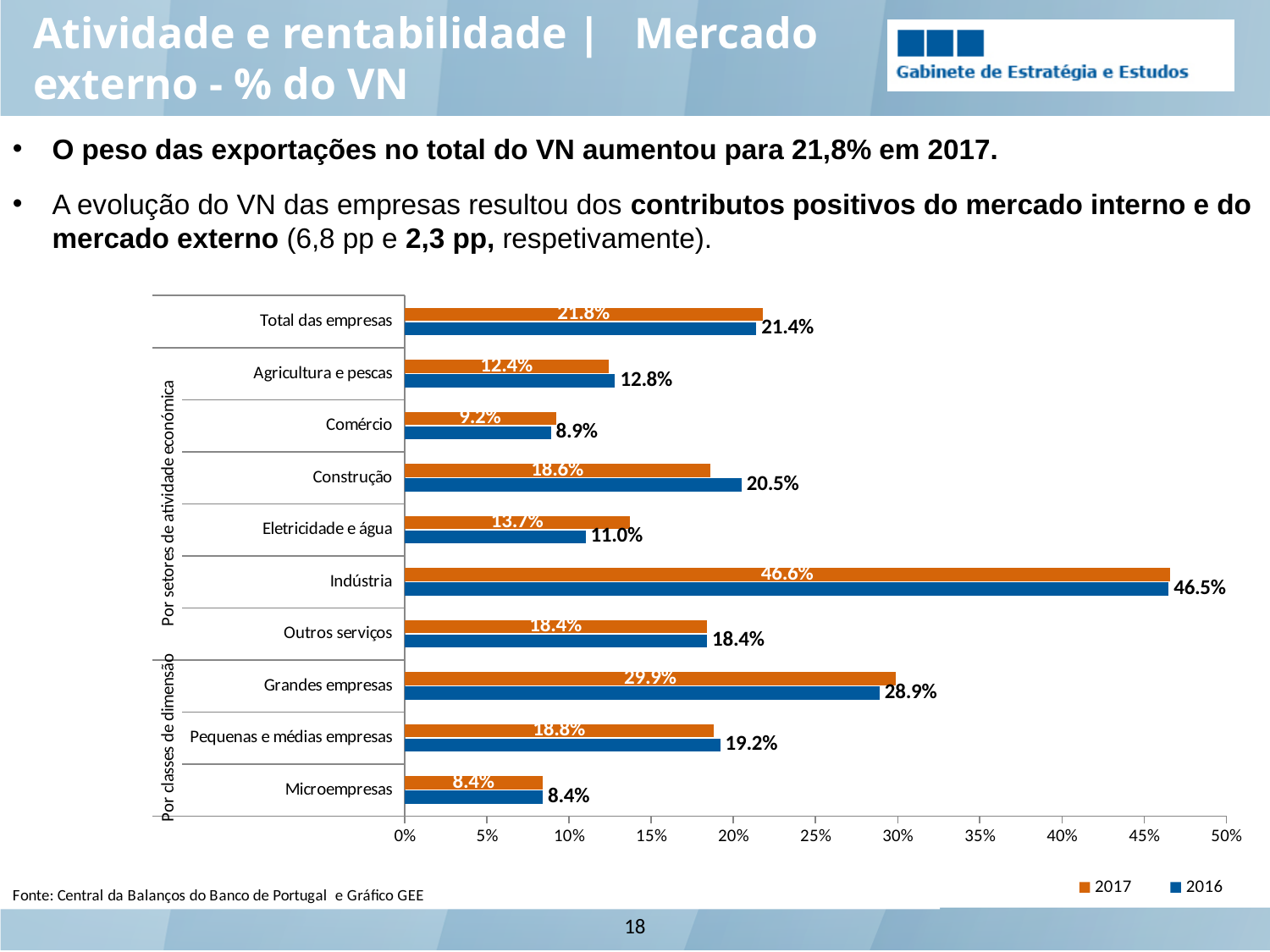
How many series does the legend list? 2 What is the 2017 value for Grandes empresas? 29.9% What kind of chart is shown on the slide? Bar chart What is the difference between the 2017 and 2016 values for Eletricidade e água? 2.7 pp Is the 2017 value for Grandes empresas greater or less than 25%? greater Which category has the lowest 2016 value? Microempresas What is the 2016 value for Construção? 20.5% Which category has the highest 2017 value? Indústria Which is larger for Construção, the 2017 value or the 2016 value? 2016 How many categories are shown on the chart? 10 What is the 2016 value for Eletricidade e água? 11.0% What is the 2017 value for Indústria? 46.6%